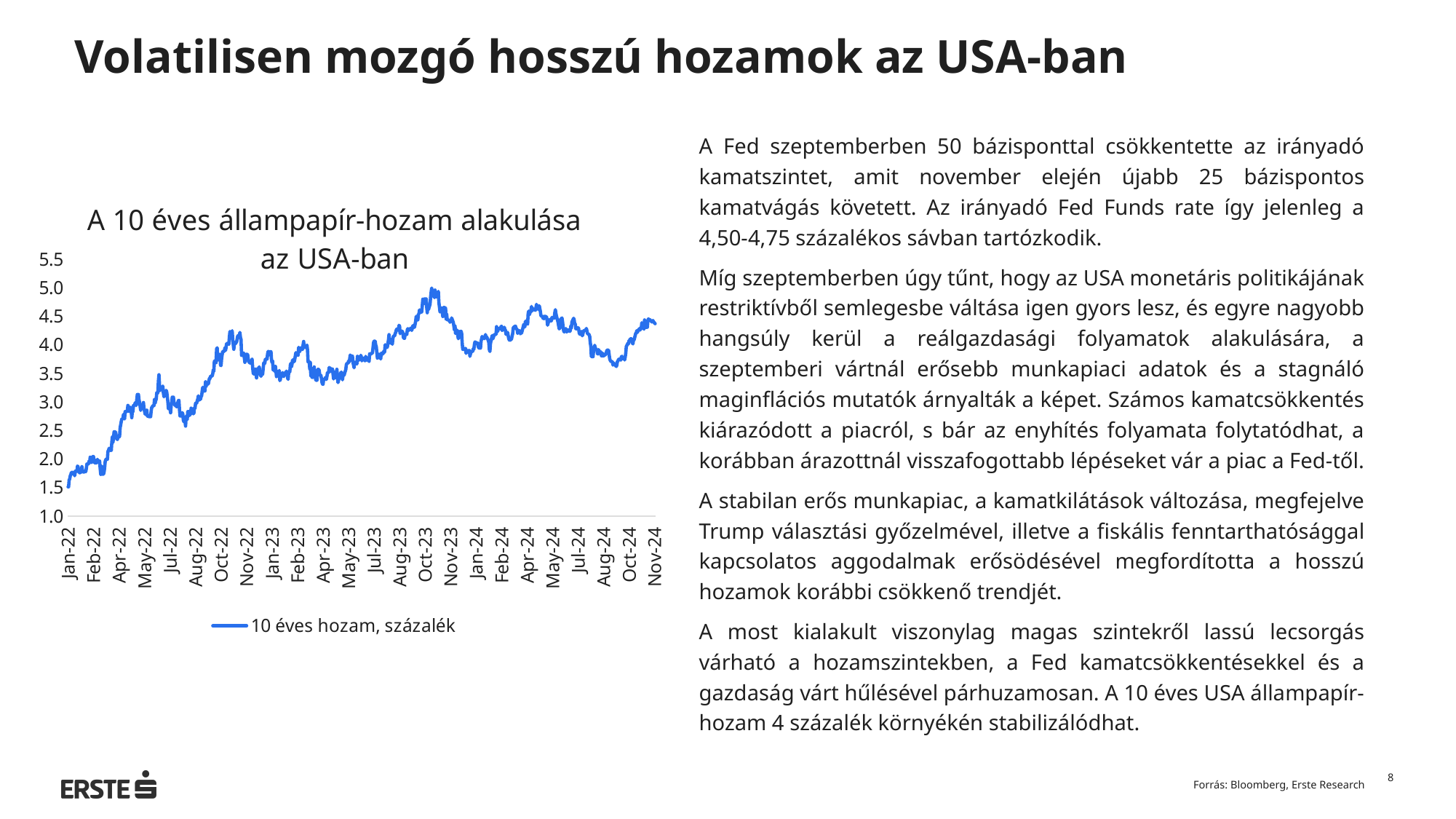
Is the value at Nov-24 greater or less than 4.0? greater What is the title of the chart? A 10 éves állampapír-hozam alakulása az USA-ban Around which x-axis label does the series have its lowest value? Jan-22 Is the value at Jan-22 greater or less than 2.0? less How many series does the chart's legend list? 1 Around which x-axis label does the series reach its highest value? Oct-23 What is the legend entry of the plotted series? 10 éves hozam, százalék Which is larger, the value at Apr-24 or the value at Aug-24? Apr-24 Is the value at Aug-24 greater or less than 4.5? less Does the series rise or fall between Jan-22 and Oct-22? rise What kind of chart is shown on the slide? line chart